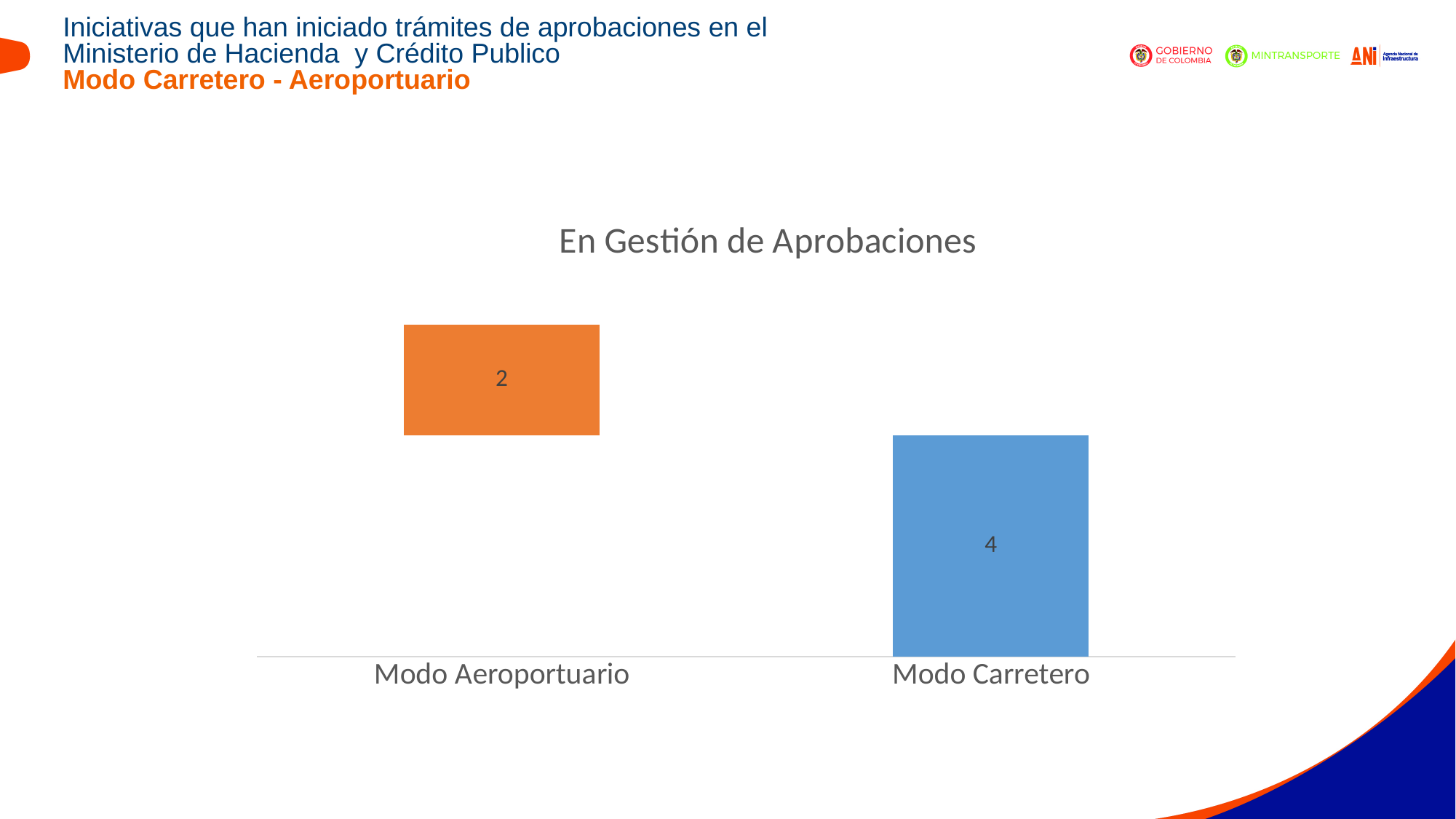
What kind of chart is shown on the slide? Bar chart Which category has the lowest value? Modo Aeroportuario What is the value shown for Modo Carretero? 4 What is the value shown for Modo Aeroportuario? 2 Which category has the highest value? Modo Carretero Which has a larger value, Modo Aeroportuario or Modo Carretero? Modo Carretero What is the title of the chart? En Gestión de Aprobaciones How many categories are shown on the x axis of the chart? 2 What is the difference between the values for Modo Carretero and Modo Aeroportuario? 2 What colour is the bar for Modo Carretero? Blue